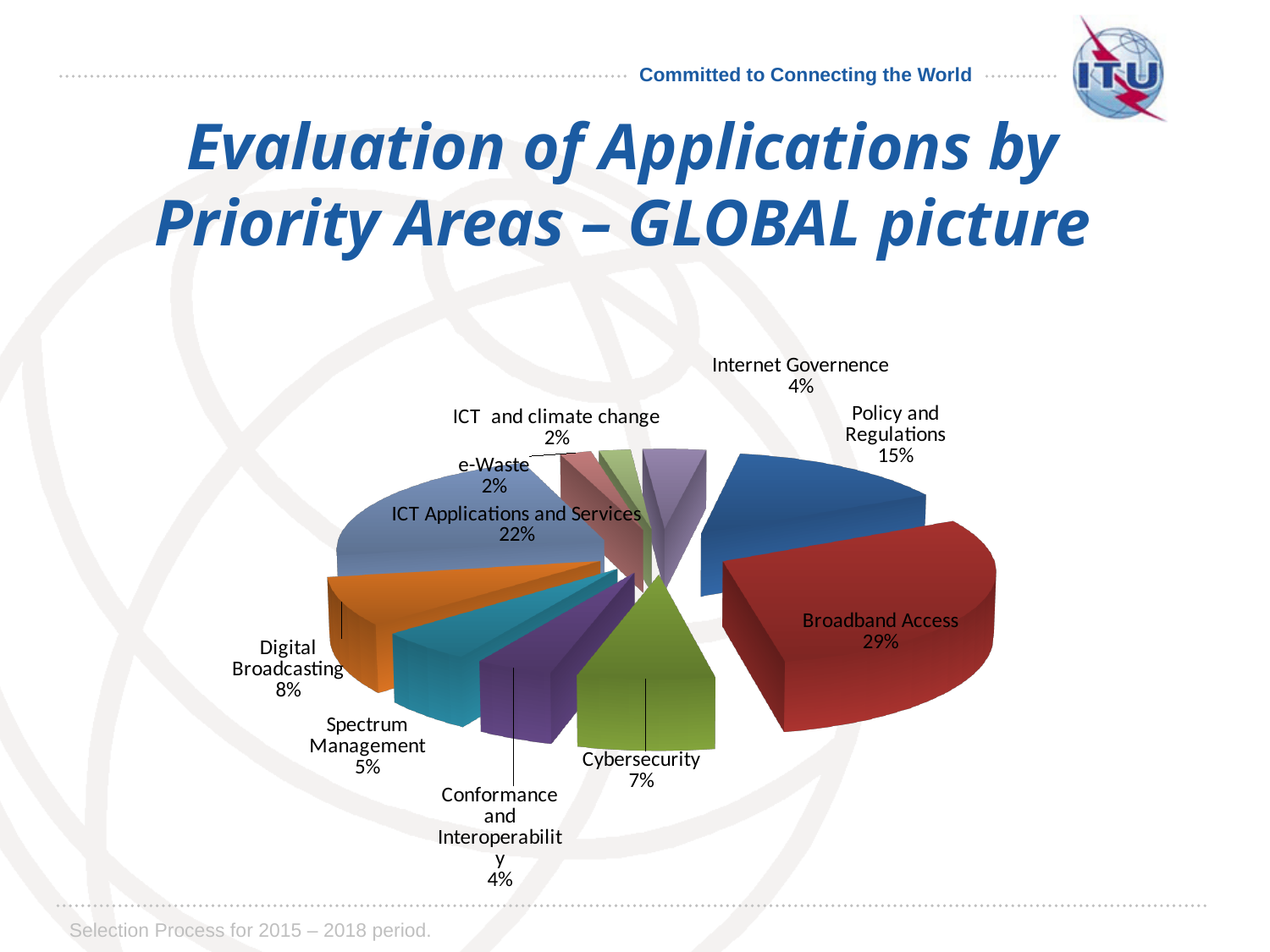
What percentage is shown for Policy and Regulations? 15% Which is larger, the share for Policy and Regulations or the share for Digital Broadcasting? Policy and Regulations What is the difference between the shares of Broadband Access and ICT Applications and Services? 7% Which priority area has the largest share of the pie? Broadband Access What is the title of the slide containing the chart? Evaluation of Applications by Priority Areas – GLOBAL picture What type of chart is shown on the slide? Pie chart What percentage is shown for Cybersecurity? 7% What is the value shown for ICT Applications and Services? 22% What is the difference between the shares of Cybersecurity and Spectrum Management? 2% What is the value for Digital Broadcasting? 8% What share of the pie does Broadband Access represent? 29% How many priority areas (slices) are shown in the pie chart? 10